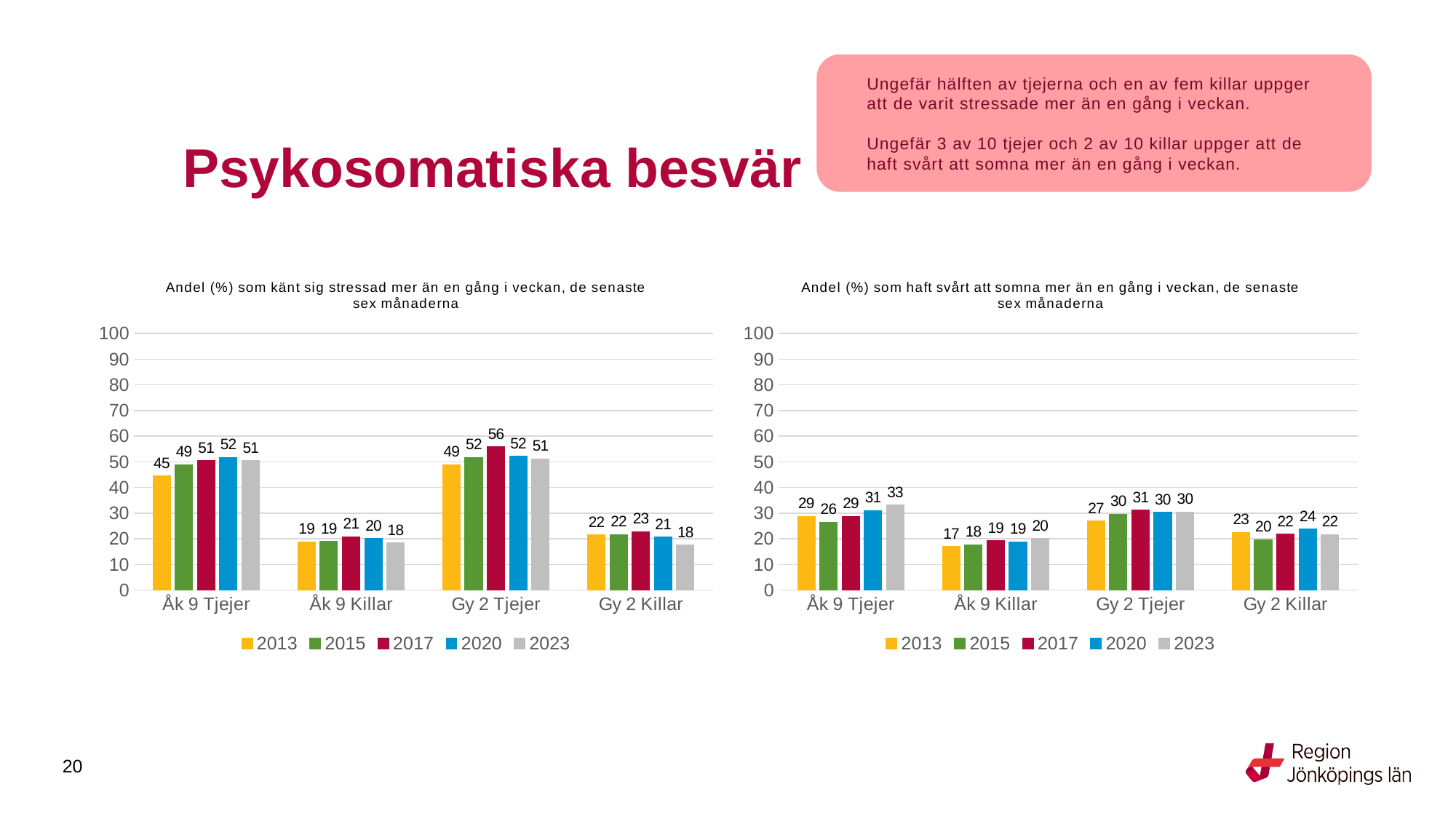
In the left chart (stressed more than once a week), what is the value for Gy 2 Tjejer in 2017? 56 What kind of chart is the left chart (stressed more than once a week)? Bar chart How many series does the legend of the left chart list? 5 In the right chart (difficulty falling asleep), which is larger: Gy 2 Tjejer in 2017 or Gy 2 Killar in 2017? Gy 2 Tjejer in 2017 How many categories are shown on the x axis of the right chart? 4 In the left chart (stressed more than once a week), what is the difference between Gy 2 Tjejer and Gy 2 Killar in 2017? 33 In the right chart (difficulty falling asleep), what is the value for Åk 9 Tjejer in 2023? 33 In the left chart (stressed more than once a week), which category has the highest value in 2013? Gy 2 Tjejer In the right chart (difficulty falling asleep), what is the value for Gy 2 Killar in 2020? 24 In the right chart (difficulty falling asleep), which category has the lowest value in 2013? Åk 9 Killar In the left chart (stressed more than once a week), what is the value for Åk 9 Killar in 2023? 18 In the right chart (difficulty falling asleep), what is the difference between Åk 9 Tjejer in 2023 and Åk 9 Tjejer in 2015? 7